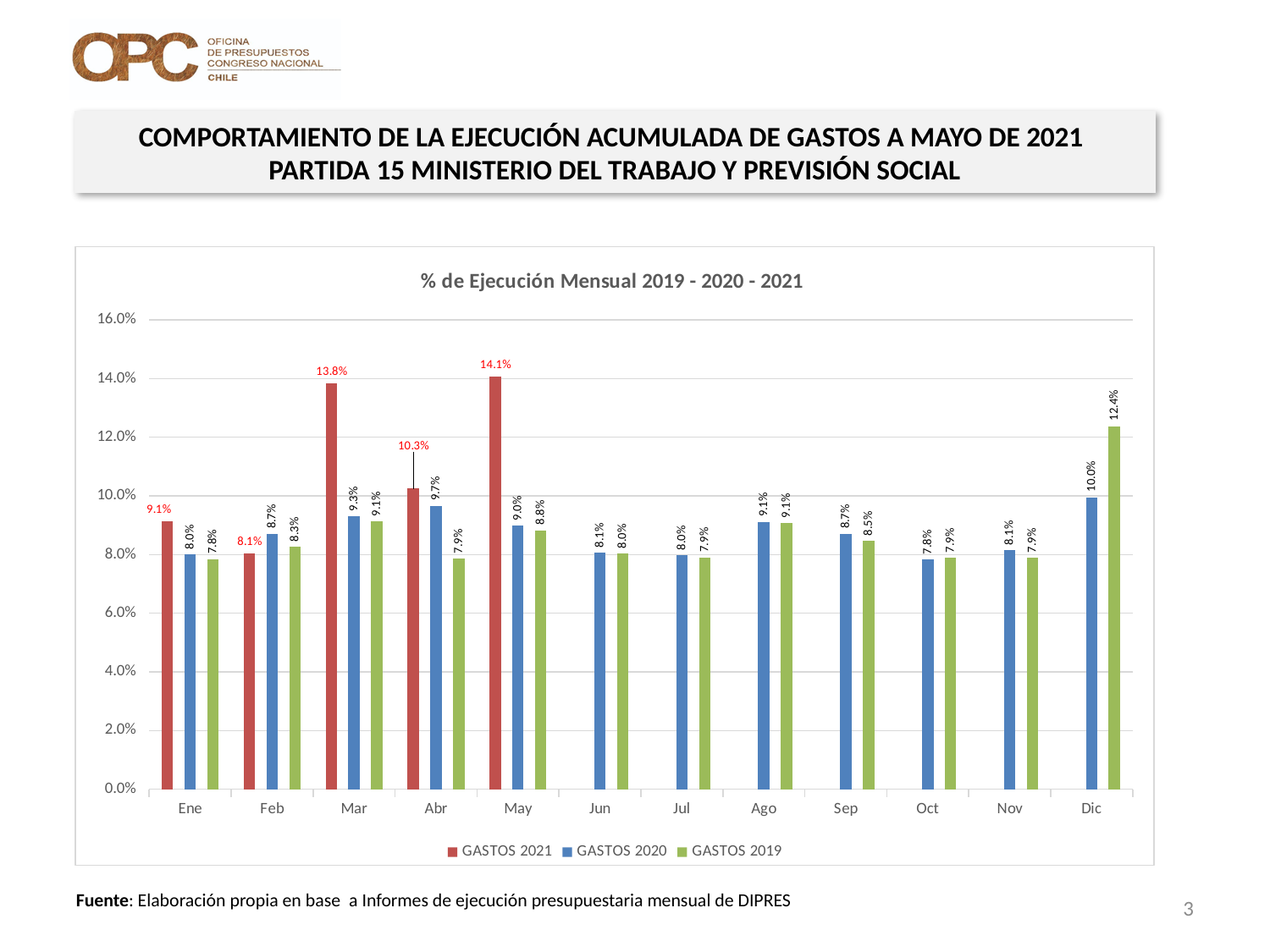
In which month is the GASTOS 2020 value lowest? Oct Is the value for GASTOS 2019 in Dic greater or less than 12.0%? greater What is the value for GASTOS 2021 in May? 14.1% What kind of chart is shown on the slide? bar chart Which is larger in Feb, GASTOS 2021 or GASTOS 2020? GASTOS 2020 What is the difference between GASTOS 2021 and GASTOS 2020 in Mar? 4.5% What is the title of the chart? % de Ejecución Mensual 2019 - 2020 - 2021 How many series does the legend list? 3 What is the value for GASTOS 2020 in Abr? 9.7% How many months are shown on the x axis? 12 In which month is the GASTOS 2021 value highest? May What is the value for GASTOS 2019 in Dic? 12.4%